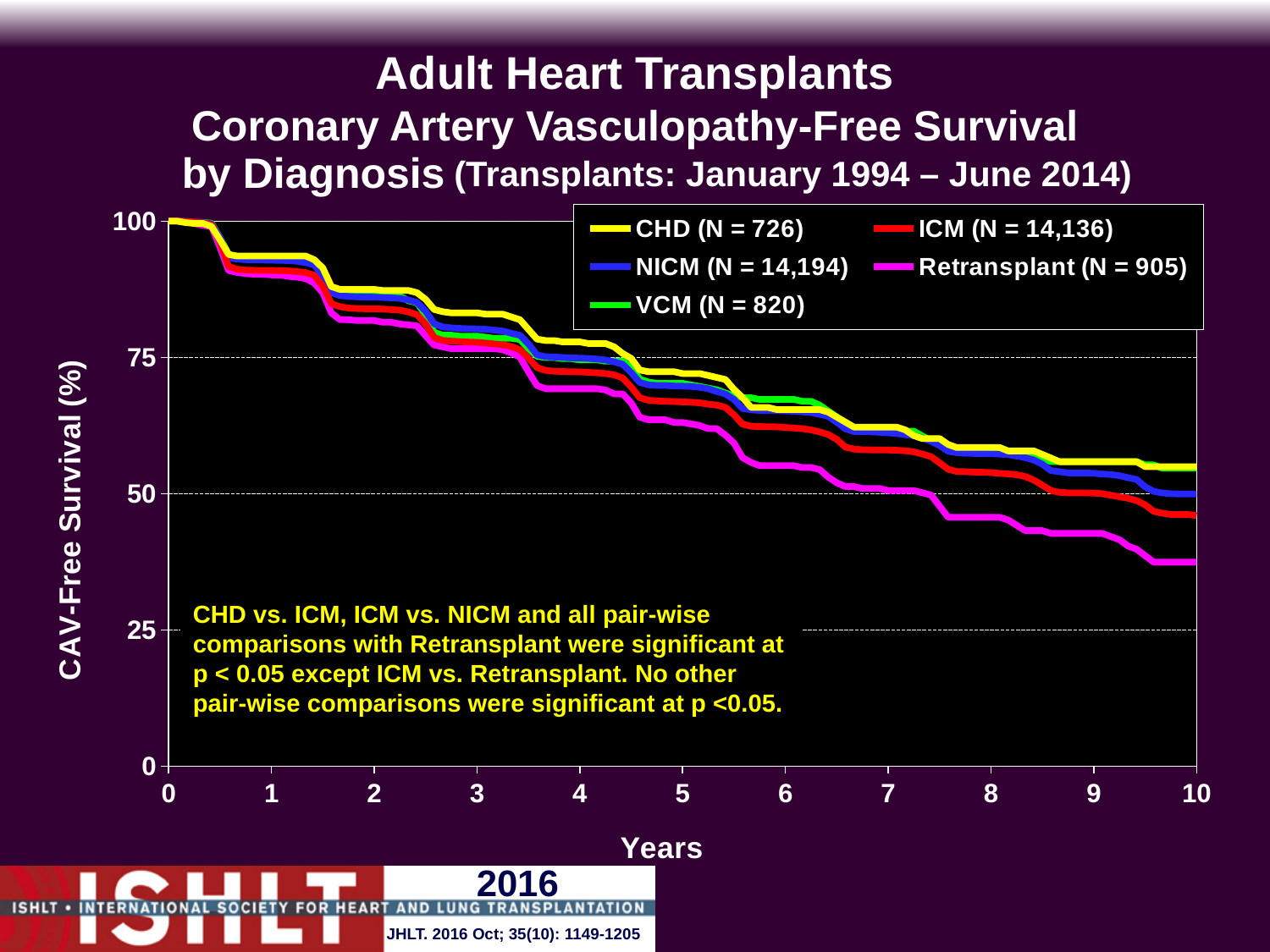
At 10 years, which has higher CAV-free survival: NICM or ICM? NICM Do the CAV-free survival curves rise or fall as years since transplant increase? fall Is the CAV-free survival for Retransplant at 5 years greater or less than 50? greater What kind of chart is shown on the slide? line chart Which diagnosis group has the lowest CAV-free survival at 10 years? Retransplant At 10 years, which has higher CAV-free survival: CHD or Retransplant? CHD Is the CAV-free survival for ICM at 10 years greater or less than 50? less Is the CAV-free survival for CHD at 10 years greater or less than 50? greater How many series does the legend list? 5 According to the legend, what is the N for the ICM group? 14,136 What is the label of the y-axis? CAV-Free Survival (%)